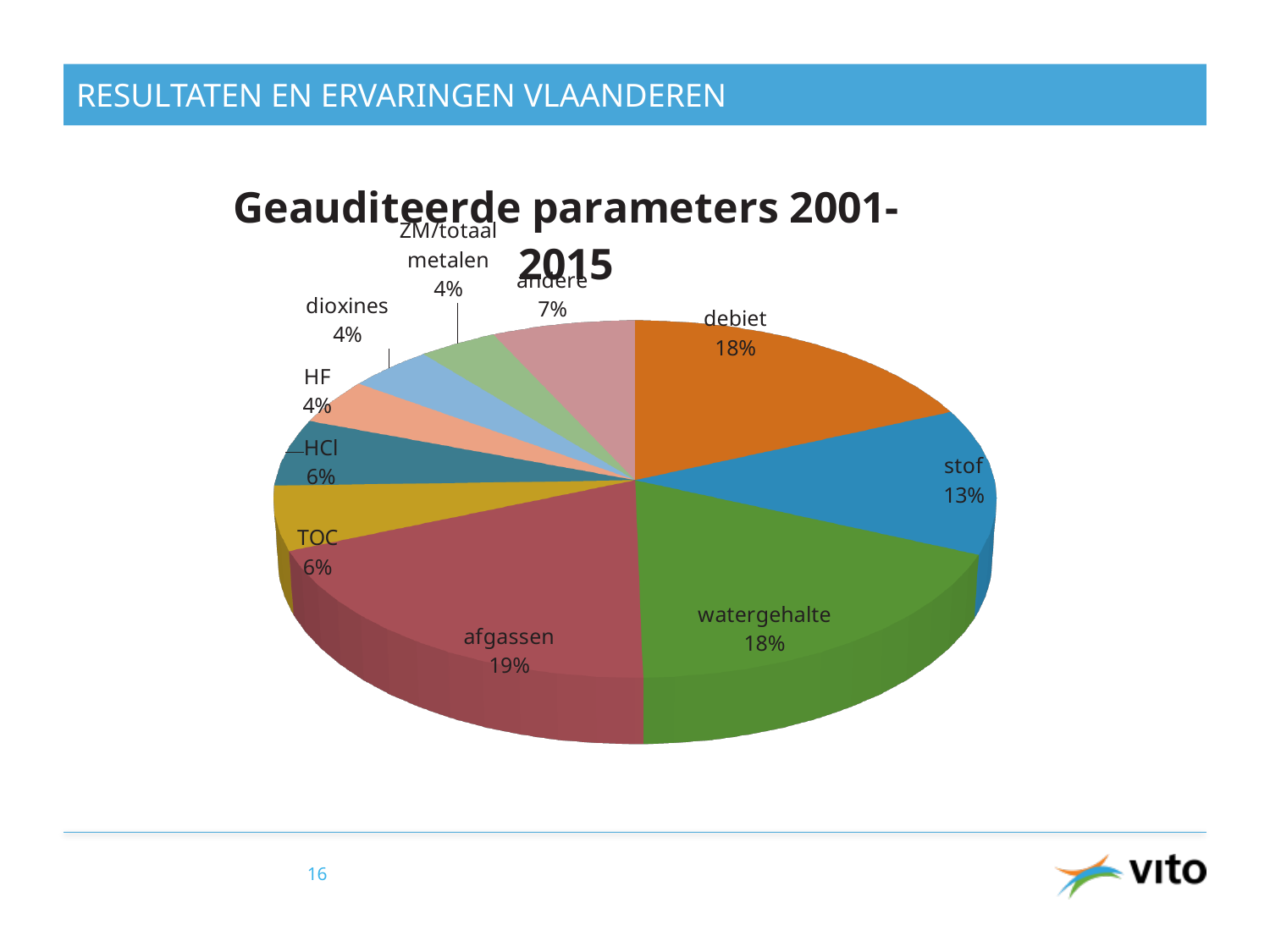
What is the difference in percentage points between debiet and stof? 5 What kind of chart is shown on the slide? pie chart What percentage is shown for stof? 13% What is the title of the chart? Geauditeerde parameters 2001-2015 What percentage is shown for HCl? 6% Which is larger, the share for TOC or the share for HF? TOC What percentage is shown for dioxines? 4% What percentage is shown for andere? 7% What share of the pie does afgassen represent? 19% How many slices does the pie chart have? 10 Which category has the largest slice of the pie? afgassen What percentage is shown for watergehalte? 18%